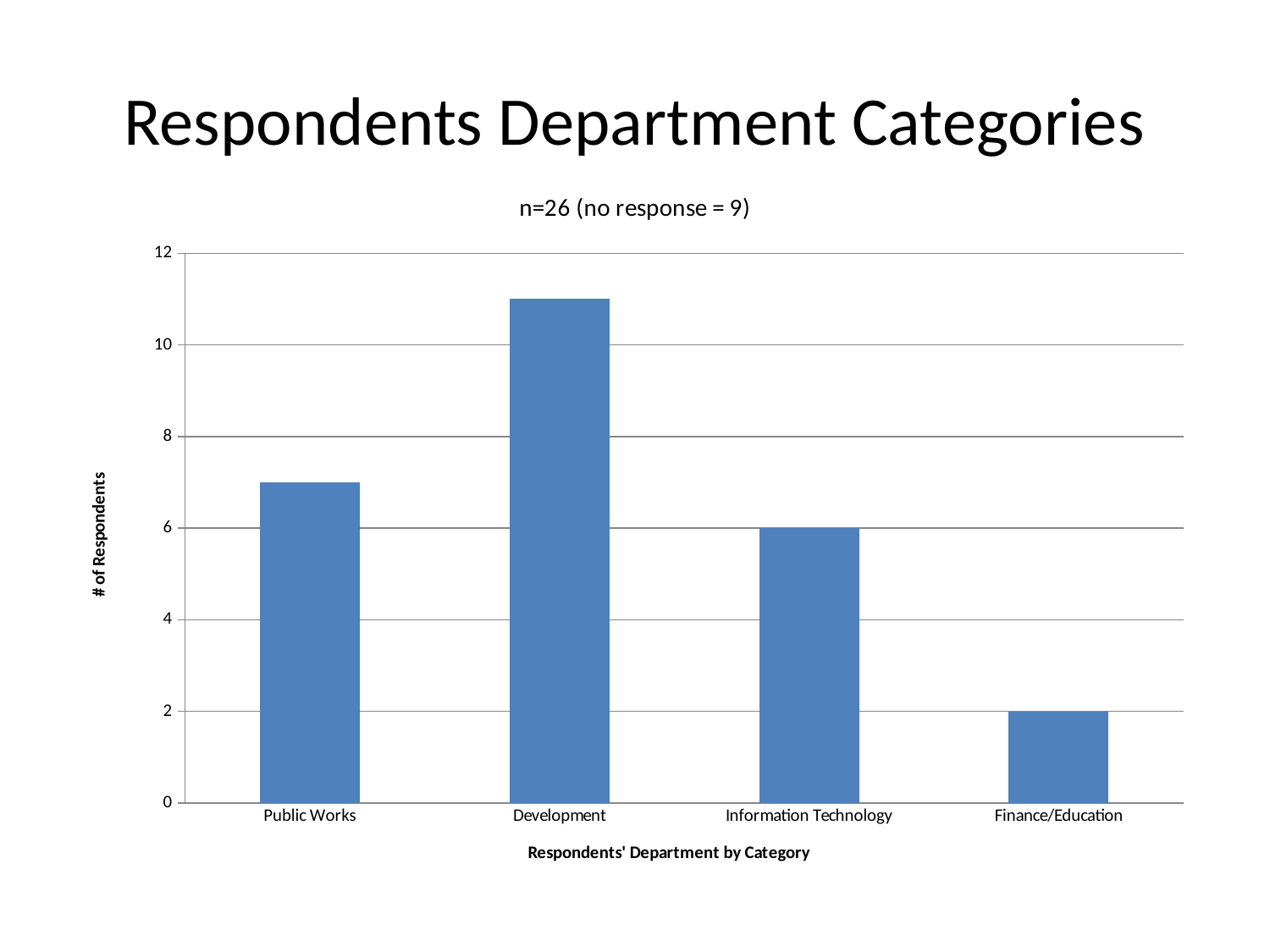
How many respondents are in the Information Technology category? 6 How many respondents are in the Finance/Education category? 2 What is the difference in respondents between Information Technology and Finance/Education? 4 Which department category has the highest number of respondents? Development Which department category has the lowest number of respondents? Finance/Education What type of chart is shown on the slide? Bar chart Which has more respondents, Public Works or Information Technology? Public Works Is the value for Development greater or less than 12? less How many department categories are plotted on the chart? 4 Is the value for Public Works greater or less than 6? greater What is the title of the vertical axis? # of Respondents Is the value for Development greater or less than 10? greater